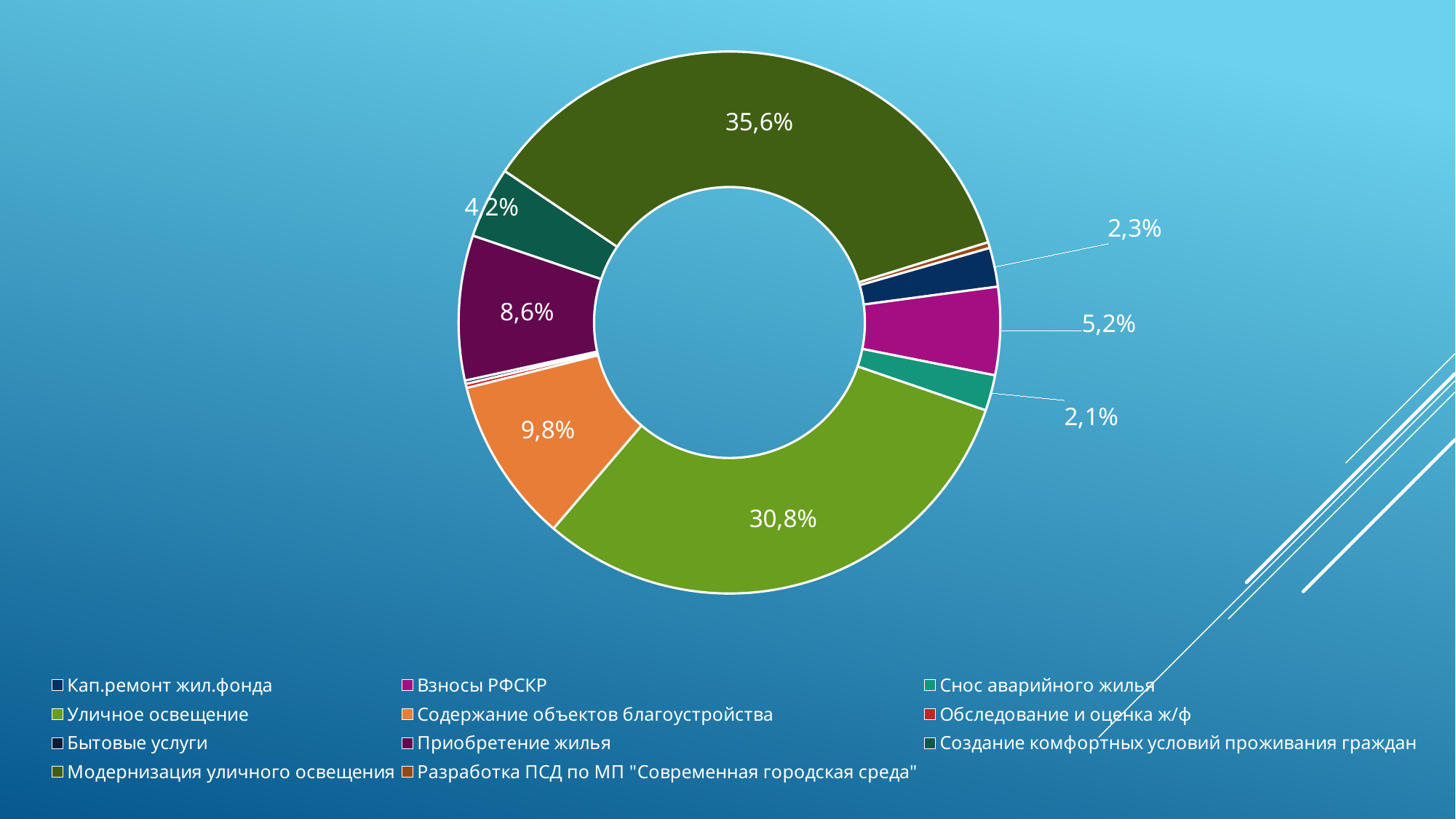
How many categories are listed in the chart legend? 11 What percentage is shown for the magenta slice (Взносы РФСКР)? 5,2% What kind of chart is shown on the slide? Doughnut (pie) chart What percentage is shown for the purple slice (Приобретение жилья)? 8,6% Which legend entry is shown in orange? Содержание объектов благоустройства What percentage is shown for the orange slice (Содержание объектов благоустройства)? 9,8% What percentage is shown for the dark teal slice (Создание комфортных условий проживания граждан)? 4,2% Which category has the largest share of the doughnut chart? Модернизация уличного освещения What share does the bright green slice (Уличное освещение) have? 30,8% What is the difference in percentage points between the 35,6% slice and the 30,8% slice? 4,8 What is the largest percentage shown on the chart? 35,6% Which slice is larger: the orange one (Содержание объектов благоустройства) or the purple one (Приобретение жилья)? Содержание объектов благоустройства